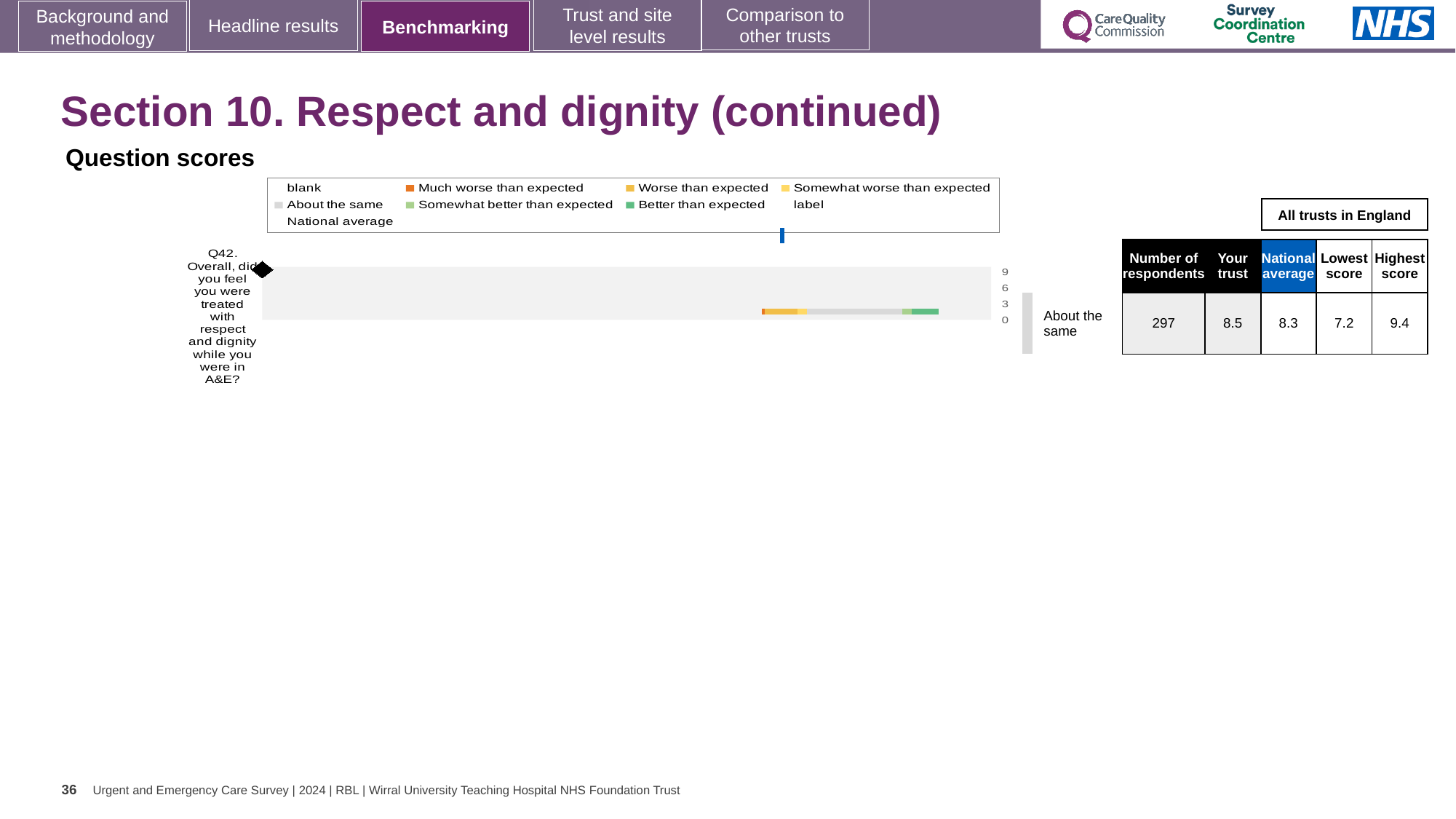
How many questions are plotted on the chart? 1 Which benchmark category is the trust's Q42 result placed in? About the same Which legend entry is shown in dark green? Better than expected What kind of chart is used to show the Q42 benchmarking result? Bar chart Which is larger for Q42: the 'Your trust' score or the national average? Your trust What is the difference between the 'Your trust' score and the national average for Q42? 0.2 What is the highest score among all trusts in England for Q42? 9.4 What is the lowest score among all trusts in England for Q42? 7.2 What is the score for 'Your trust' for Q42 (Overall, did you feel you were treated with respect and dignity while you were in A&E?)? 8.5 What is the difference between the highest and lowest scores among all trusts in England for Q42? 2.2 What is the national average score shown for Q42? 8.3 How many respondents answered Q42? 297